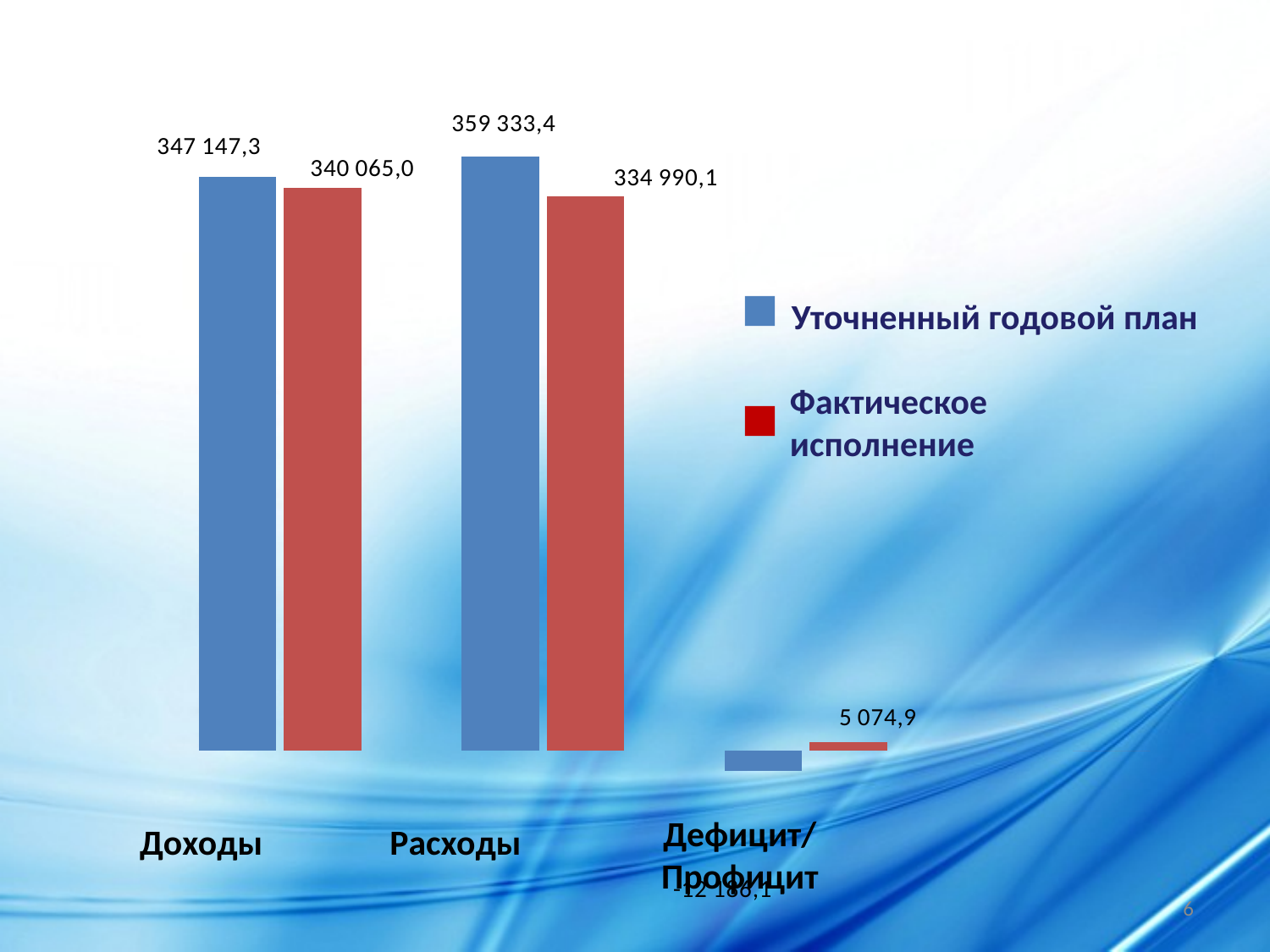
What is the value of Фактическое исполнение for Расходы? 334 990,1 What is the difference between Уточненный годовой план and Фактическое исполнение for Доходы? 7 082,3 Which category has the lowest value for Фактическое исполнение? Дефицит/Профицит How many series does the legend list? 2 What is the difference between Уточненный годовой план and Фактическое исполнение for Расходы? 24 343,3 What is the value of Уточненный годовой план for Доходы? 347 147,3 What is the value of Фактическое исполнение for Дефицит/Профицит? 5 074,9 What is the value of Фактическое исполнение for Доходы? 340 065,0 Which category has the highest value for Уточненный годовой план? Расходы What kind of chart is shown on the slide? Bar chart What is the value of Уточненный годовой план for Расходы? 359 333,4 Which is larger for Расходы: Уточненный годовой план or Фактическое исполнение? Уточненный годовой план